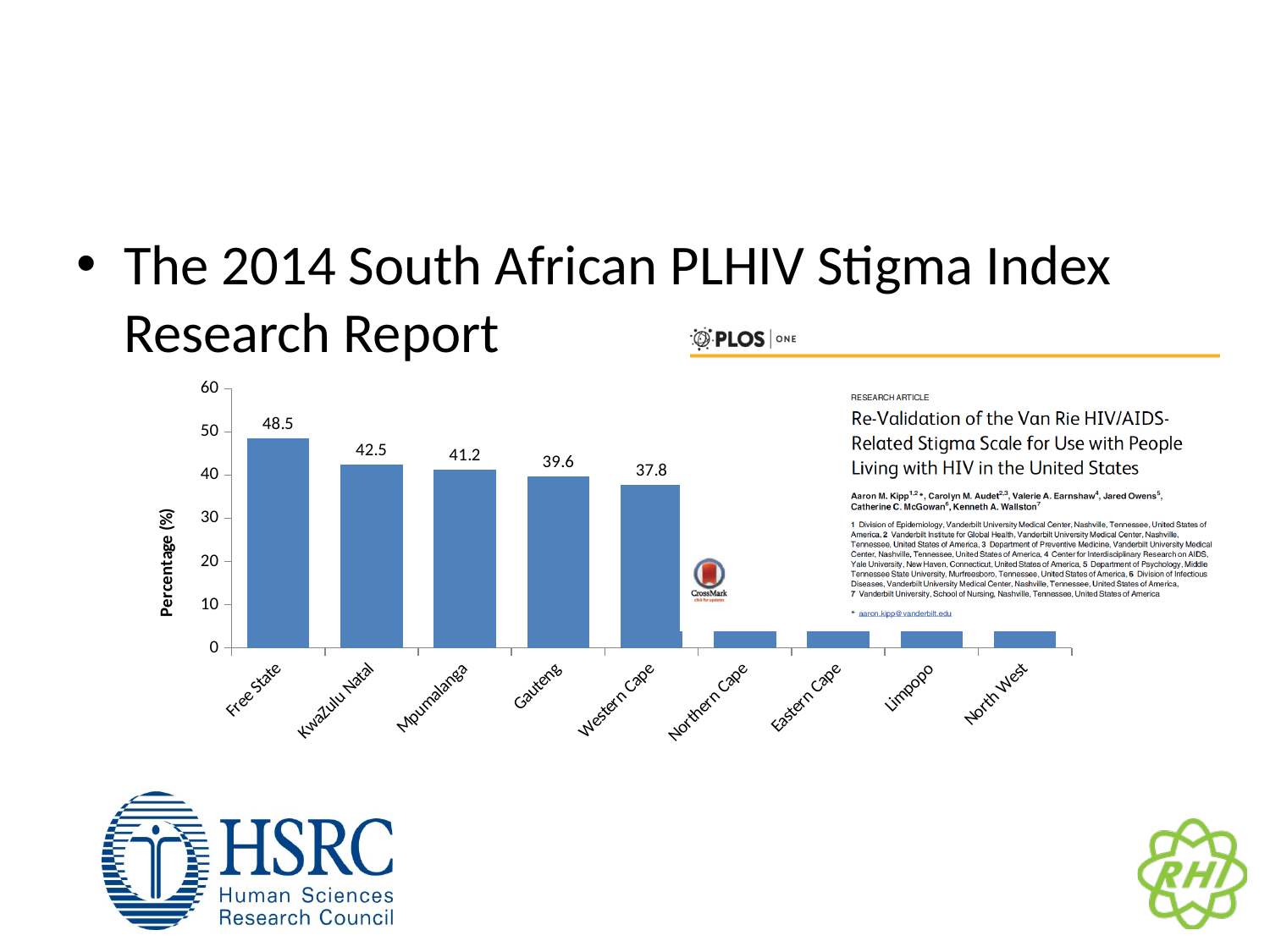
What is the value for KwaZulu Natal? 42.5 What is the value for Western Cape? 37.8 How many provinces are shown on the x axis? 9 What is the label of the y axis? Percentage (%) What is the difference between the values for Free State and Western Cape? 10.7 What is the value for Gauteng? 39.6 What is the value for Free State? 48.5 What kind of chart is shown? bar chart Which is larger, the value for KwaZulu Natal or the value for Gauteng? KwaZulu Natal What is the value for Mpumalanga? 41.2 Which province has the highest value? Free State